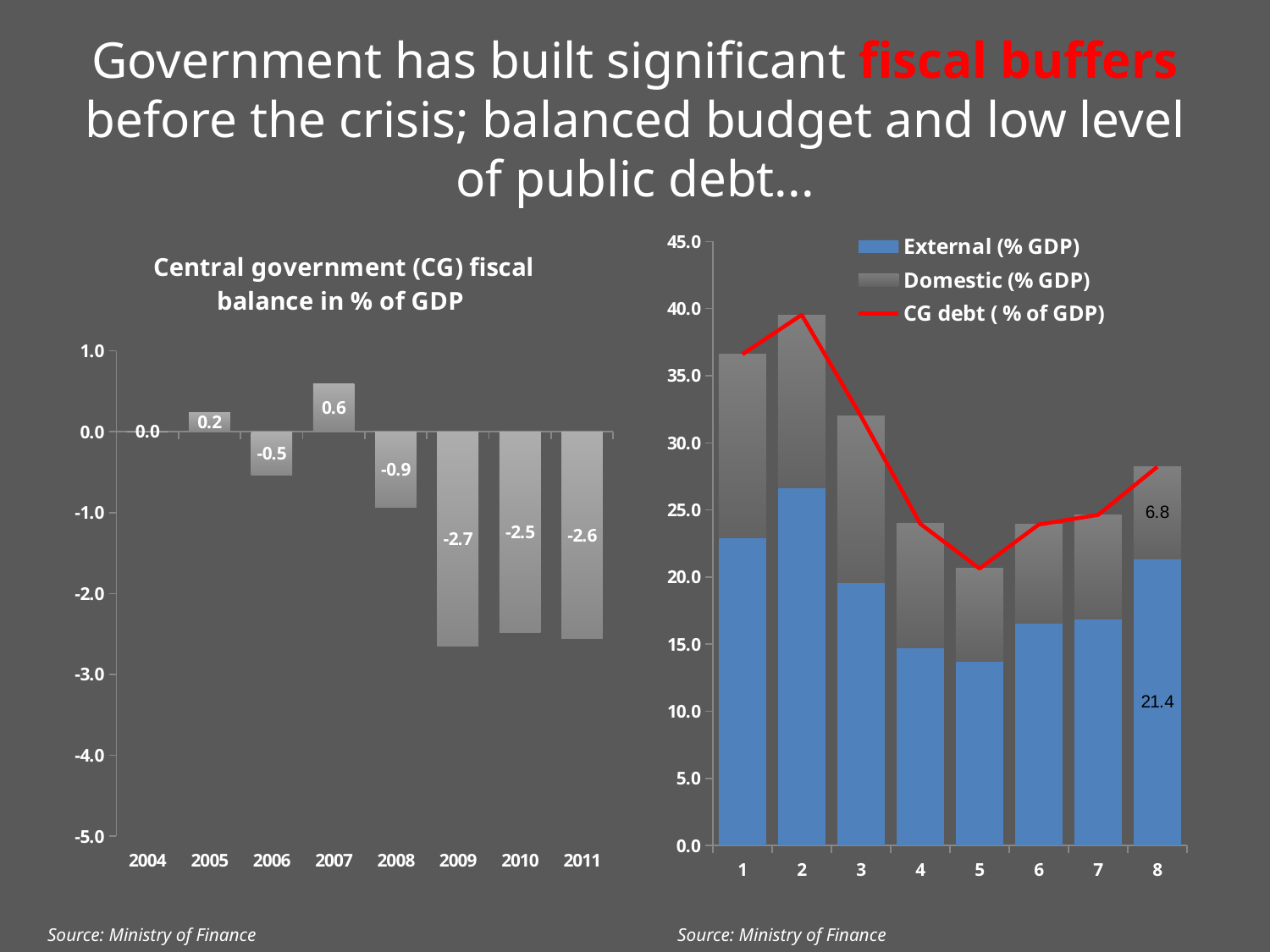
What kind of chart is the left chart (Central government fiscal balance)? Bar chart On the left chart (Central government fiscal balance), which year has the larger value, 2010 or 2011? 2010 On the left chart (Central government fiscal balance), what is the value for 2007? 0.6 On the right chart, what is the total of the stacked bar for category 8 (External plus Domestic)? 28.2 On the left chart (Central government fiscal balance), which year has the lowest fiscal balance? 2009 On the left chart (Central government fiscal balance), what is the value for 2009? -2.7 On the right chart, how many series does the legend list? 3 On the left chart (Central government fiscal balance), what is the difference between the 2007 and 2008 values? 1.5 On the left chart (Central government fiscal balance), how many years are shown on the x axis? 8 On the left chart (Central government fiscal balance), which year has the highest fiscal balance? 2007 On the right chart, what is the External (% GDP) value for category 8? 21.4 On the right chart, is the External (% GDP) value for category 2 greater or less than 25.0? greater